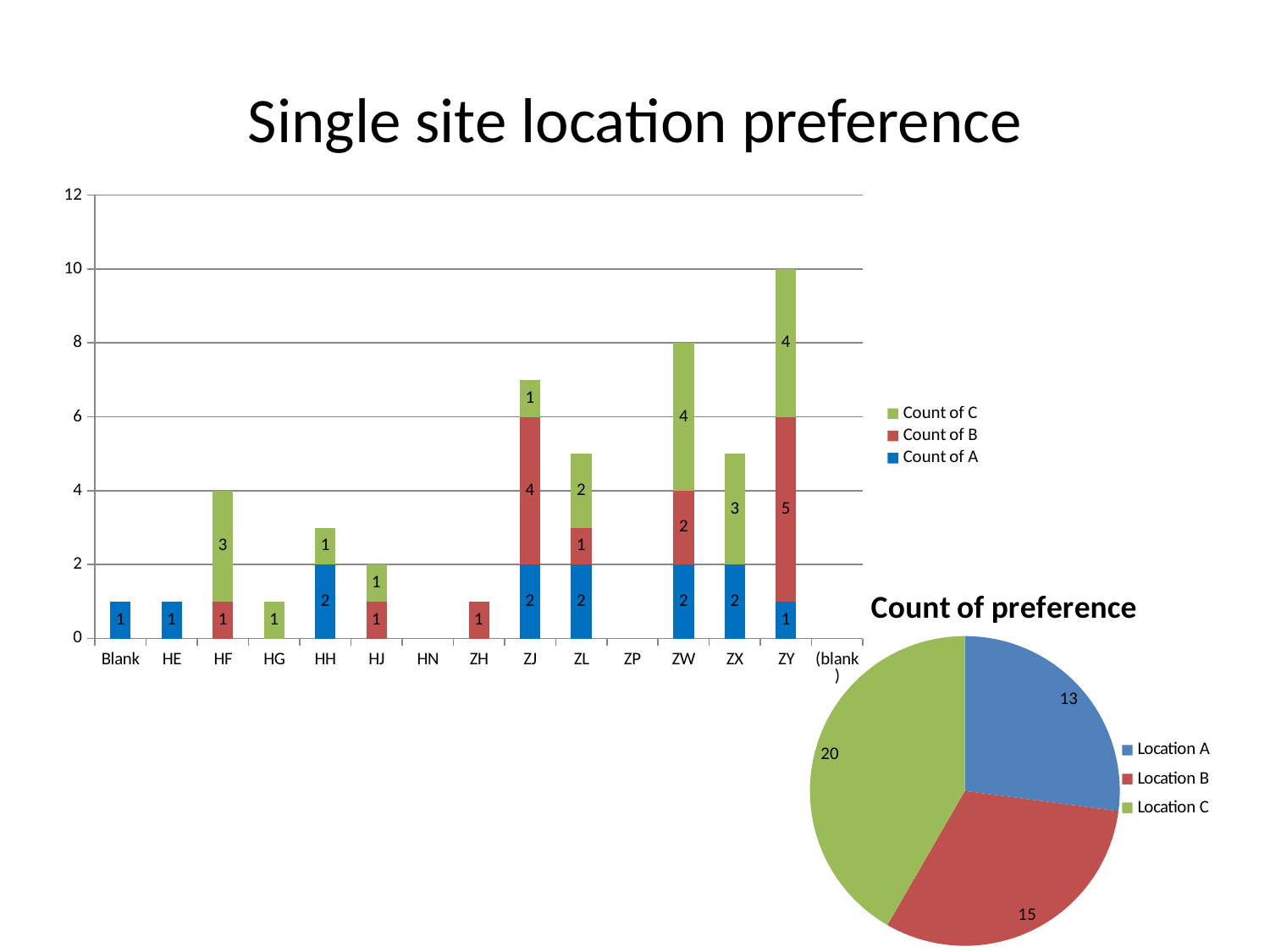
In the stacked bar chart, what is the Count of C value for ZW? 4 In the 'Count of preference' pie chart, what is the value for Location B? 15 In the 'Count of preference' pie chart, which location has the largest slice? Location C In the 'Count of preference' pie chart, what is the difference between Location C and Location A? 7 How many series does the legend of the stacked bar chart list? 3 In the stacked bar chart, what is the Count of B value for ZY? 5 In the stacked bar chart, what is the difference between the Count of B values for ZY and ZJ? 1 In the stacked bar chart, what is the total of the stacked bar for ZJ? 7 In the stacked bar chart, which is larger: the Count of C for HF or the Count of C for ZX? They are equal (3) In the stacked bar chart, what is the total of the stacked bar for ZW? 8 In the stacked bar chart, what is the Count of A value for HH? 2 In the stacked bar chart, which category has the tallest stacked bar? ZY